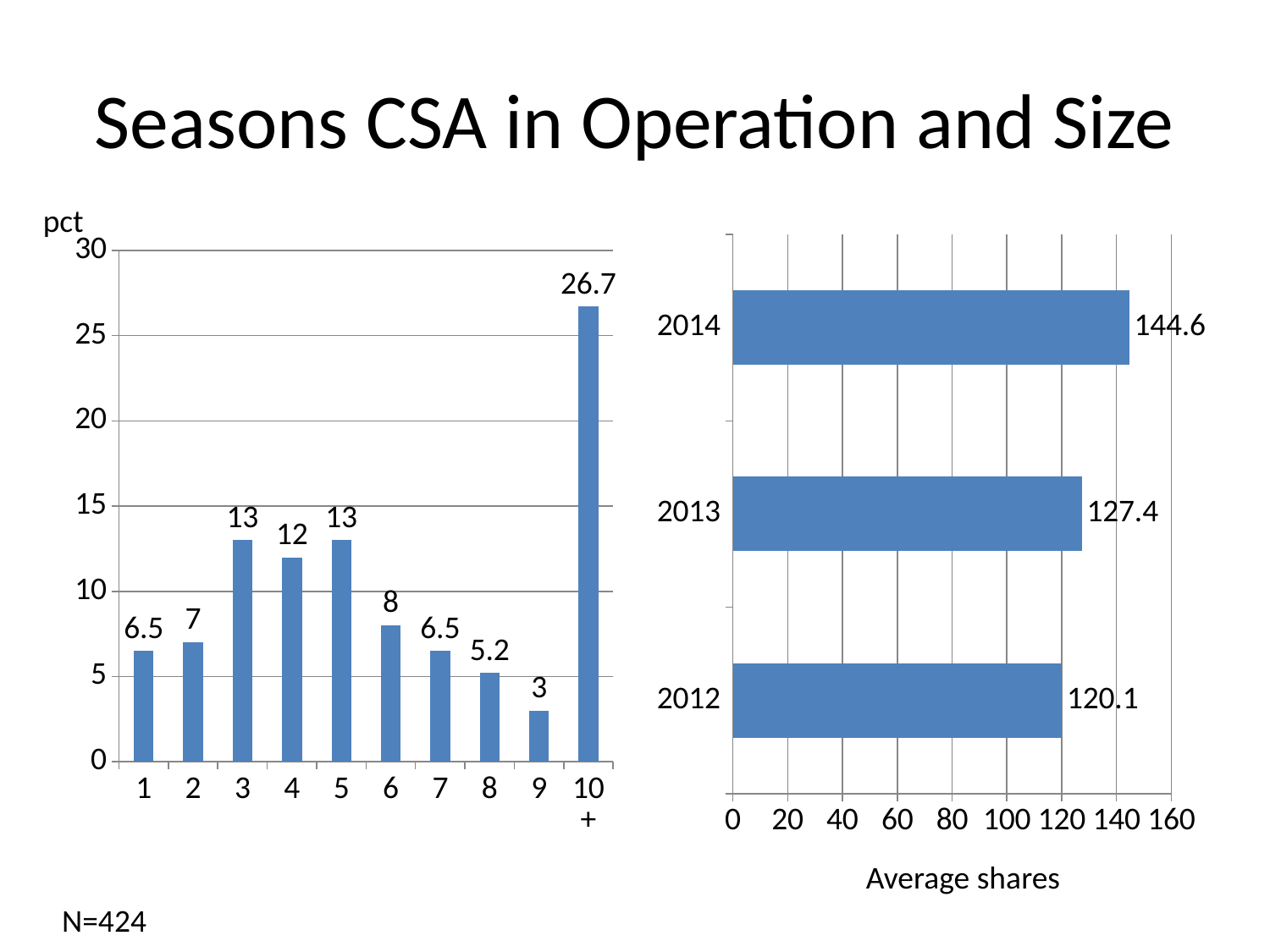
What kind of chart is the right chart (Average shares)? bar chart In the right chart (Average shares), which year has the highest value? 2014 In the right chart (Average shares), what is the difference between the values for 2014 and 2012? 24.5 In the left chart (seasons in operation, pct), is the value for category 8 larger or smaller than the value for category 2? smaller In the left chart (seasons in operation, pct), what is the difference between the values for category 6 and category 9? 5 In the right chart (Average shares), do the values rise or fall from 2012 to 2014? rise In the right chart (Average shares), what is the value for 2013? 127.4 In the left chart (seasons in operation, pct), which category has the highest value? 10+ In the left chart (seasons in operation, pct), what is the value for category 4? 12 In the left chart (seasons in operation, pct), how many categories are shown on the x axis? 10 In the left chart (seasons in operation, pct), what is the value for category 10+? 26.7 In the left chart (seasons in operation, pct), which category has the lowest value? 9